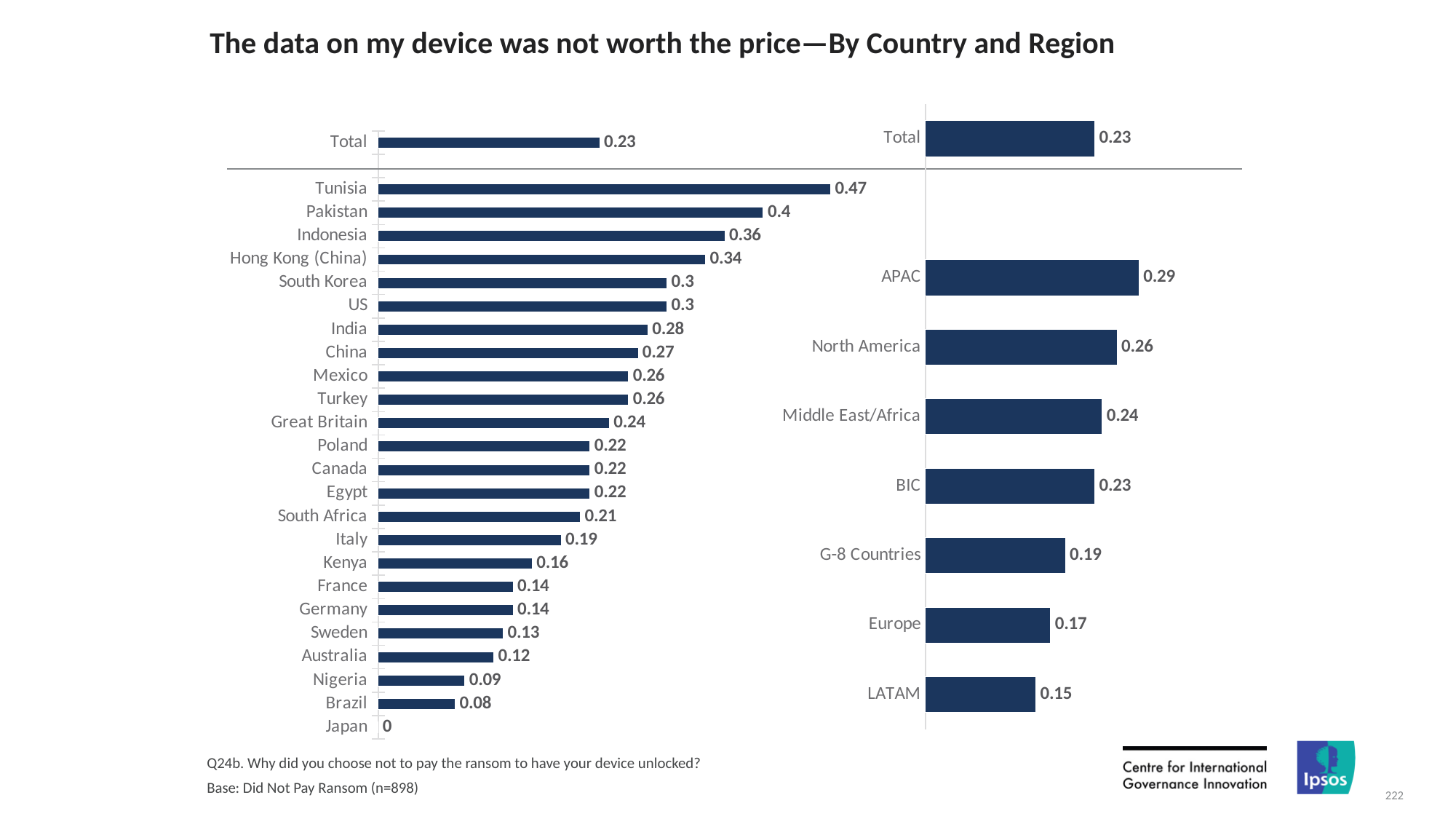
What type of chart is used on this slide? Bar chart In the left chart (by country), what is the difference between the values for Tunisia and Pakistan? 0.07 What is the title of the slide's chart? The data on my device was not worth the price—By Country and Region In the left chart (by country), what is the value for Tunisia? 0.47 In the right chart (by region), what is the difference between the values for APAC and Europe? 0.12 In the right chart (by region), which region has the highest value? APAC In the left chart (by country), which country has the lowest value? Japan In the right chart (by region), which region has the lowest value? LATAM In the right chart (by region), how many regions are shown below the Total bar? 7 In the left chart (by country), which has a larger value, Indonesia or India? Indonesia In the left chart (by country), what is the value for Kenya? 0.16 In the right chart (by region), what is the value for Middle East/Africa? 0.24